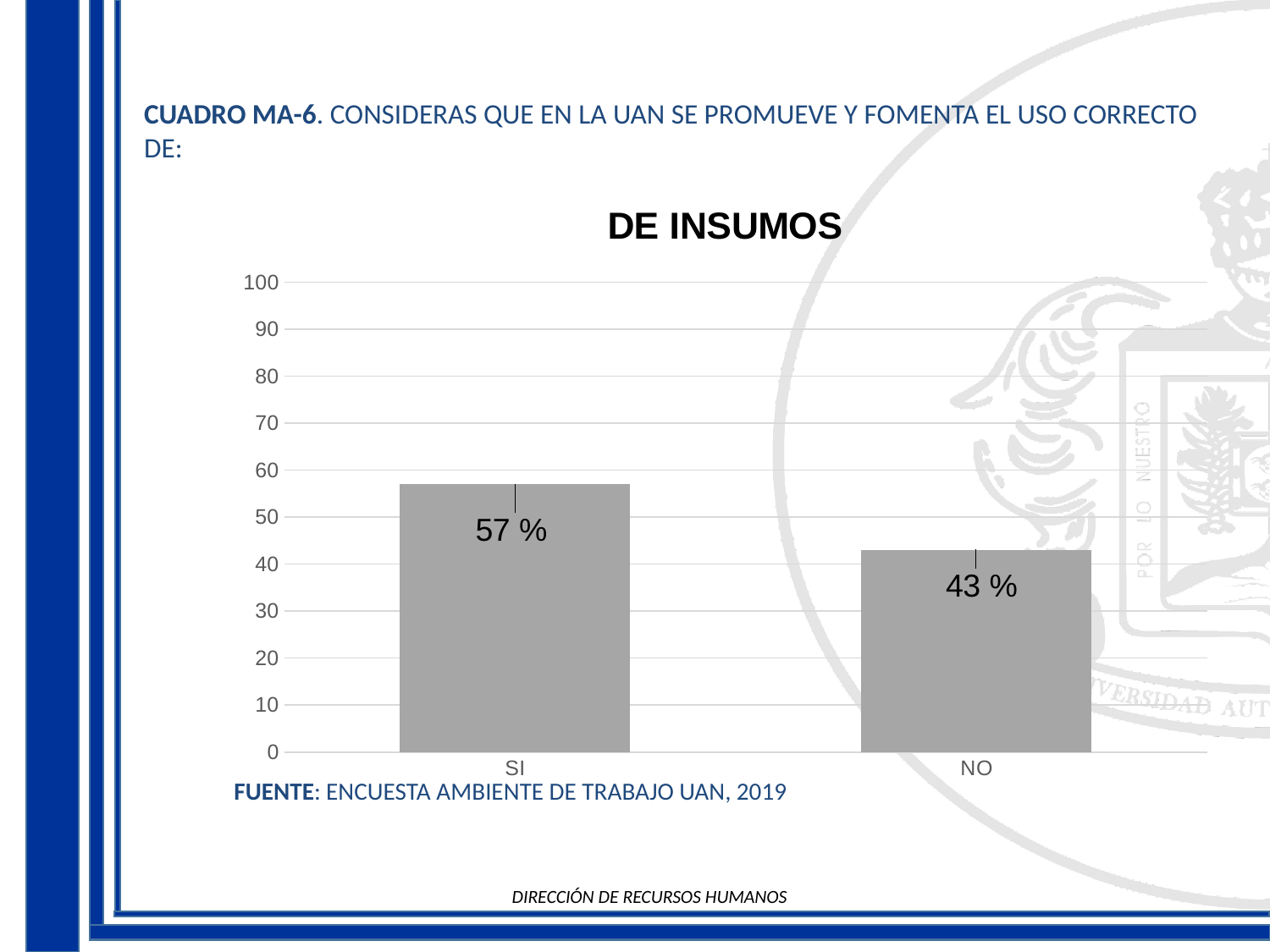
What kind of chart is shown on the slide? bar chart Is the value for NO greater or less than 50? less What is the maximum value shown on the y axis? 100 What is the title of the chart? DE INSUMOS Which category has the highest value? SI What is the difference between the values for SI and NO? 14 % Is the value for SI greater or less than 50? greater How many categories are shown on the x axis? 2 What is the value for NO? 43 % Which category has the lowest value? NO Which is larger, the value for SI or the value for NO? SI What is the value for SI? 57 %